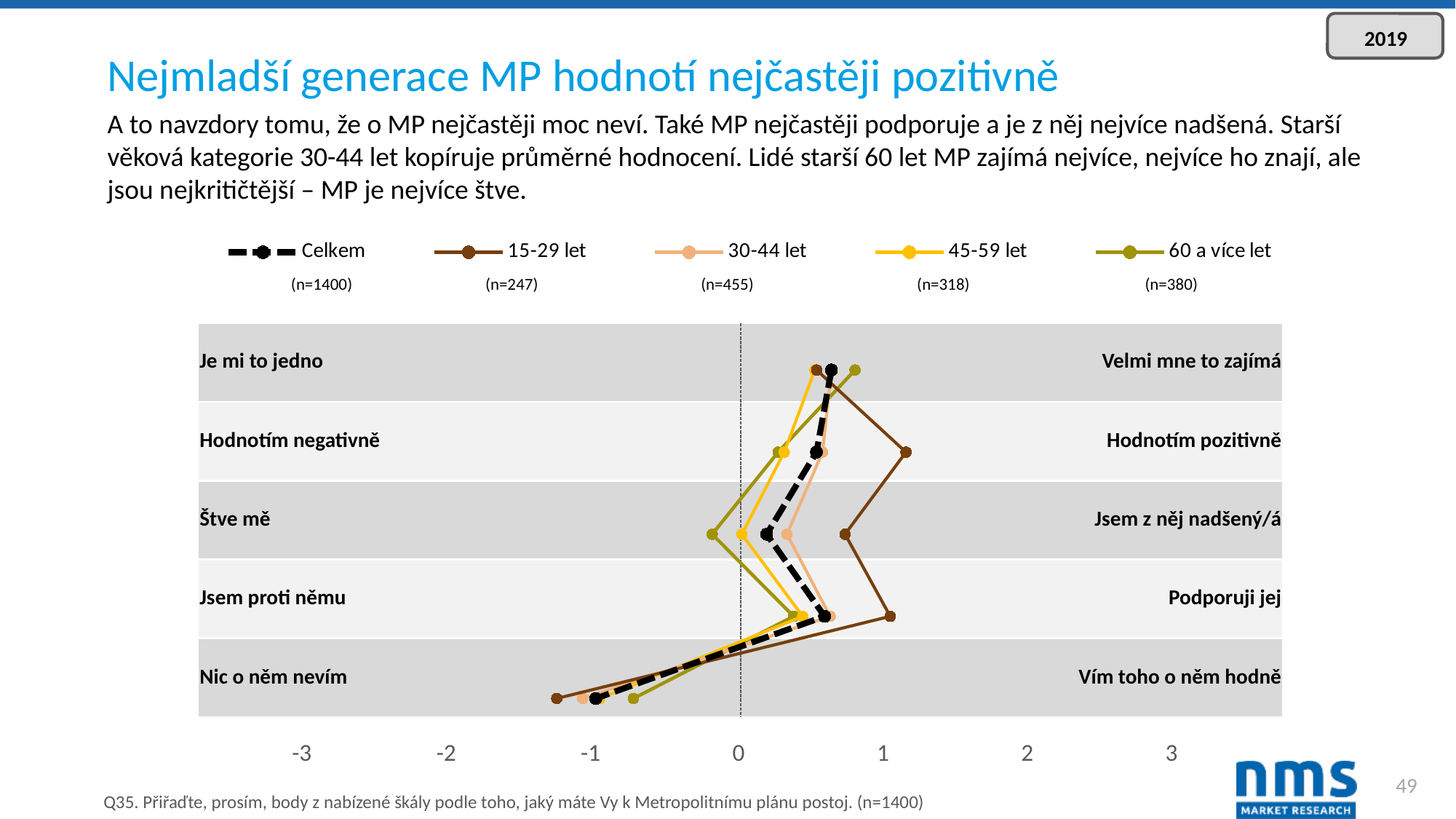
Which series has the highest value on the 'Hodnotím negativně – Hodnotím pozitivně' scale? 15-29 let How many attitude scales (rows) are plotted on the chart? 5 Is the value for 60 a více let on the 'Nic o něm nevím – Vím toho o něm hodně' scale greater or less than -1? greater Is the value for 60 a více let on the 'Štve mě – Jsem z něj nadšený/á' scale greater or less than 0? less Which series has the lowest value on the 'Nic o něm nevím – Vím toho o něm hodně' scale? 15-29 let Which series has the lowest value on the 'Štve mě – Jsem z něj nadšený/á' scale? 60 a více let What sample size (n) is shown in the legend for the 'Celkem' series? n=1400 Is the value for 15-29 let on the 'Hodnotím negativně – Hodnotím pozitivně' scale greater or less than 1? greater What kind of chart is shown on the slide? line chart How many series does the legend list? 5 Which series has the highest value on the 'Je mi to jedno – Velmi mne to zajímá' scale? 60 a více let On the 'Jsem proti němu – Podporuji jej' scale, which is larger: the value for 15-29 let or the value for 45-59 let? 15-29 let